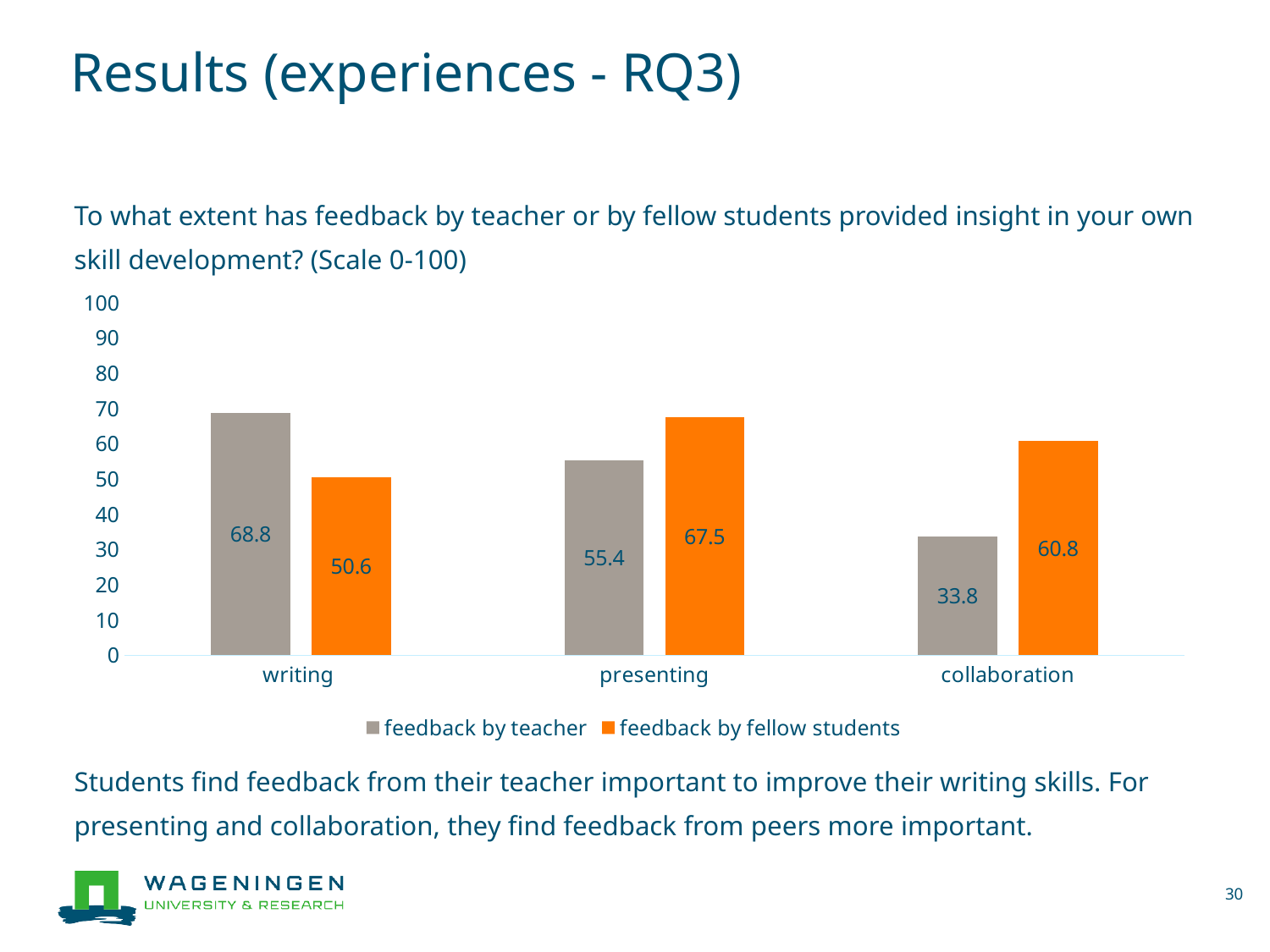
How many series does the legend list? 2 What is the value for feedback by fellow students for collaboration? 60.8 How many categories are shown on the x axis? 3 Is the value for feedback by teacher for presenting greater or less than 50? greater What is the value for feedback by teacher for writing? 68.8 Which category has the lowest value for feedback by teacher? collaboration For writing, which is larger: feedback by teacher or feedback by fellow students? feedback by teacher Which colour represents feedback by fellow students in the legend? orange Which category has the highest value for feedback by fellow students? presenting What is the difference between feedback by teacher and feedback by fellow students for collaboration? 27 What kind of chart is shown on the slide? bar chart What is the value for feedback by fellow students for presenting? 67.5